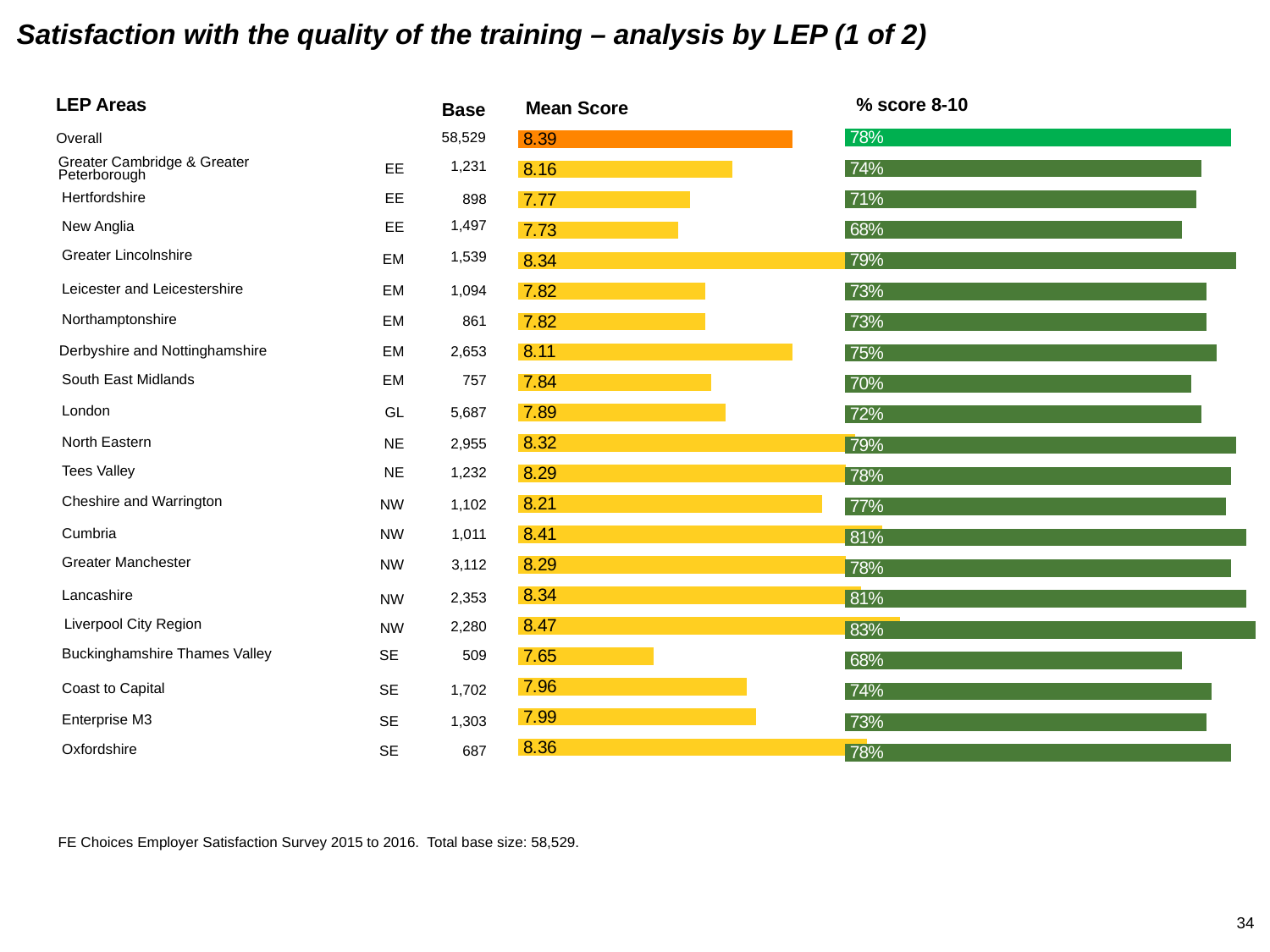
What type of chart is used to show the % score 8-10 values? Bar chart In the Mean Score chart, what is the Overall mean score? 8.39 How many LEP areas (excluding Overall) are listed in the Mean Score chart? 20 In the % score 8-10 chart, which LEP area has the highest percentage? Liverpool City Region In the Mean Score chart, what is the mean score for Liverpool City Region? 8.47 In the Mean Score chart, what is the difference between the mean scores for Cumbria and Hertfordshire? 0.64 In the % score 8-10 chart, what is the value for Cumbria? 81% In the % score 8-10 chart, which is higher, Tees Valley or South East Midlands? Tees Valley In the Mean Score chart, which LEP area has the highest mean score? Liverpool City Region In the Mean Score chart, which LEP area has the lowest mean score? Buckinghamshire Thames Valley In the Mean Score chart, which has a higher mean score, London or North Eastern? North Eastern In the % score 8-10 chart, what is the difference between the values for Greater Lincolnshire and New Anglia? 11%